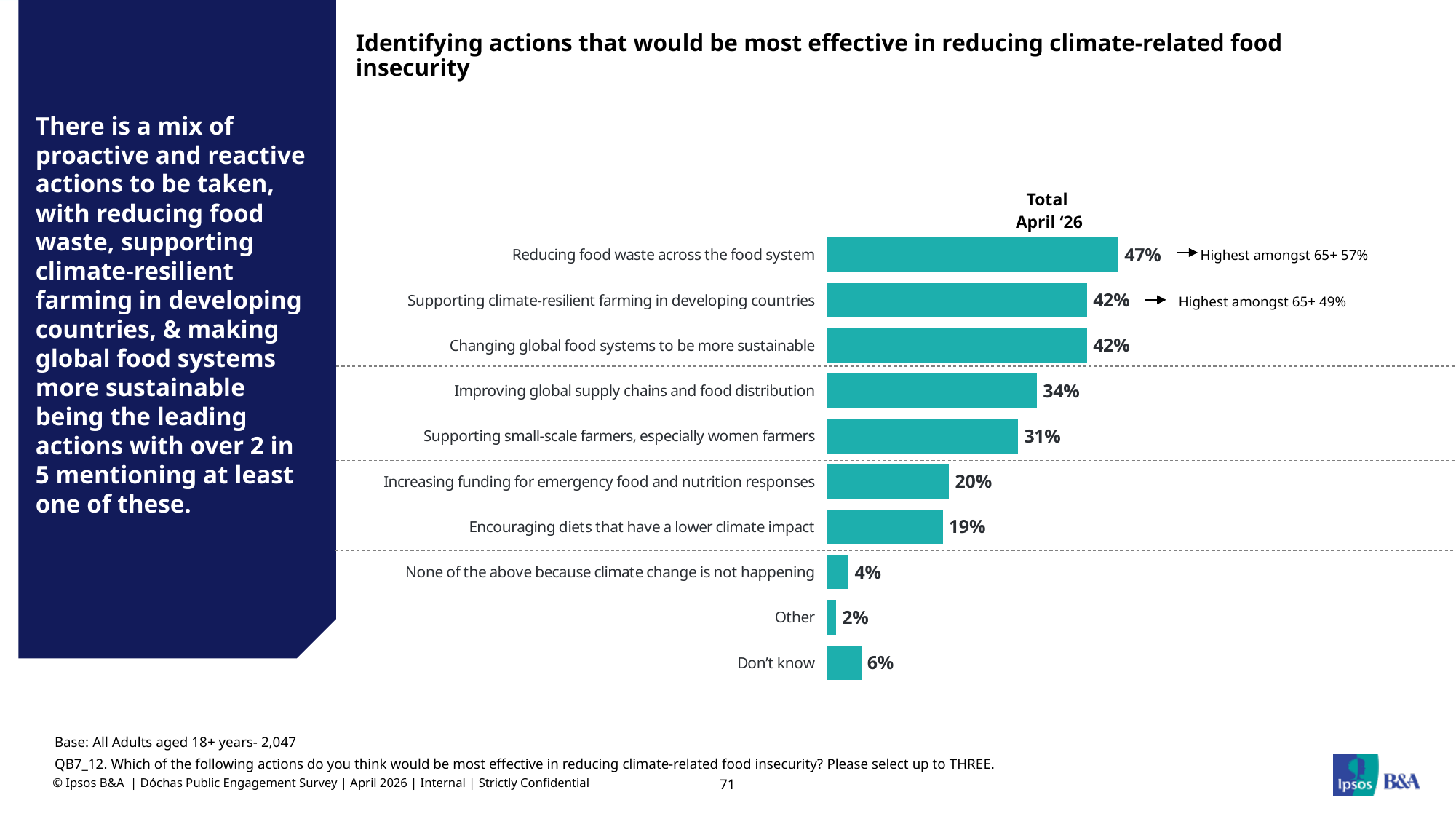
What is the value for 'Improving global supply chains and food distribution'? 34% Which category has the lowest percentage? Other What kind of chart is shown on the slide? Bar chart What is the value for 'Don't know'? 6% What is the column header above the bars? Total April '26 What percentage selected 'Reducing food waste across the food system'? 47% According to the annotation, what is the value for 'Reducing food waste across the food system' amongst those aged 65+? 57% What is the difference between 'Reducing food waste across the food system' and 'Supporting small-scale farmers, especially women farmers'? 16 percentage points Which is larger: 'Increasing funding for emergency food and nutrition responses' or 'Encouraging diets that have a lower climate impact'? Increasing funding for emergency food and nutrition responses Which action has the highest percentage? Reducing food waste across the food system What percentage chose 'Encouraging diets that have a lower climate impact'? 19% How many categories are shown in the chart? 10